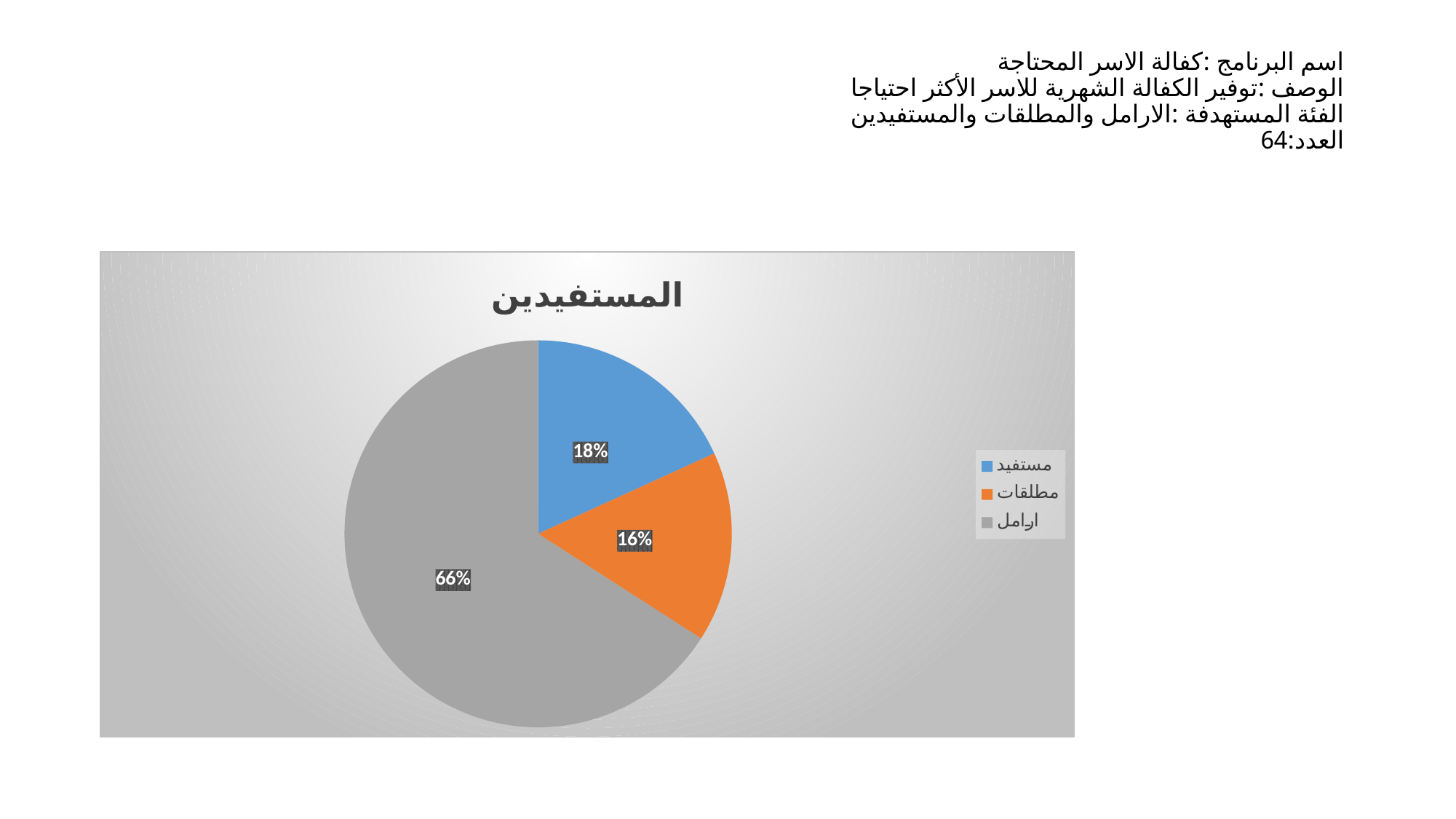
How many entries does the legend list? 3 What is the difference in percentage points between the ارامل slice and the مستفيد slice? 48% What share of the pie does the ارامل slice represent? 66% What type of chart is shown on the slide? pie chart Which category has the smallest slice of the pie? مطلقات Which slice is larger, مستفيد or مطلقات? مستفيد What share of the pie does the مستفيد slice represent? 18% What is the title of the chart? المستفيدين Which colour represents the ارامل category in the pie chart? gray What share of the pie does the مطلقات slice represent? 16% How many slices does the pie chart have? 3 Which category has the largest slice of the pie? ارامل